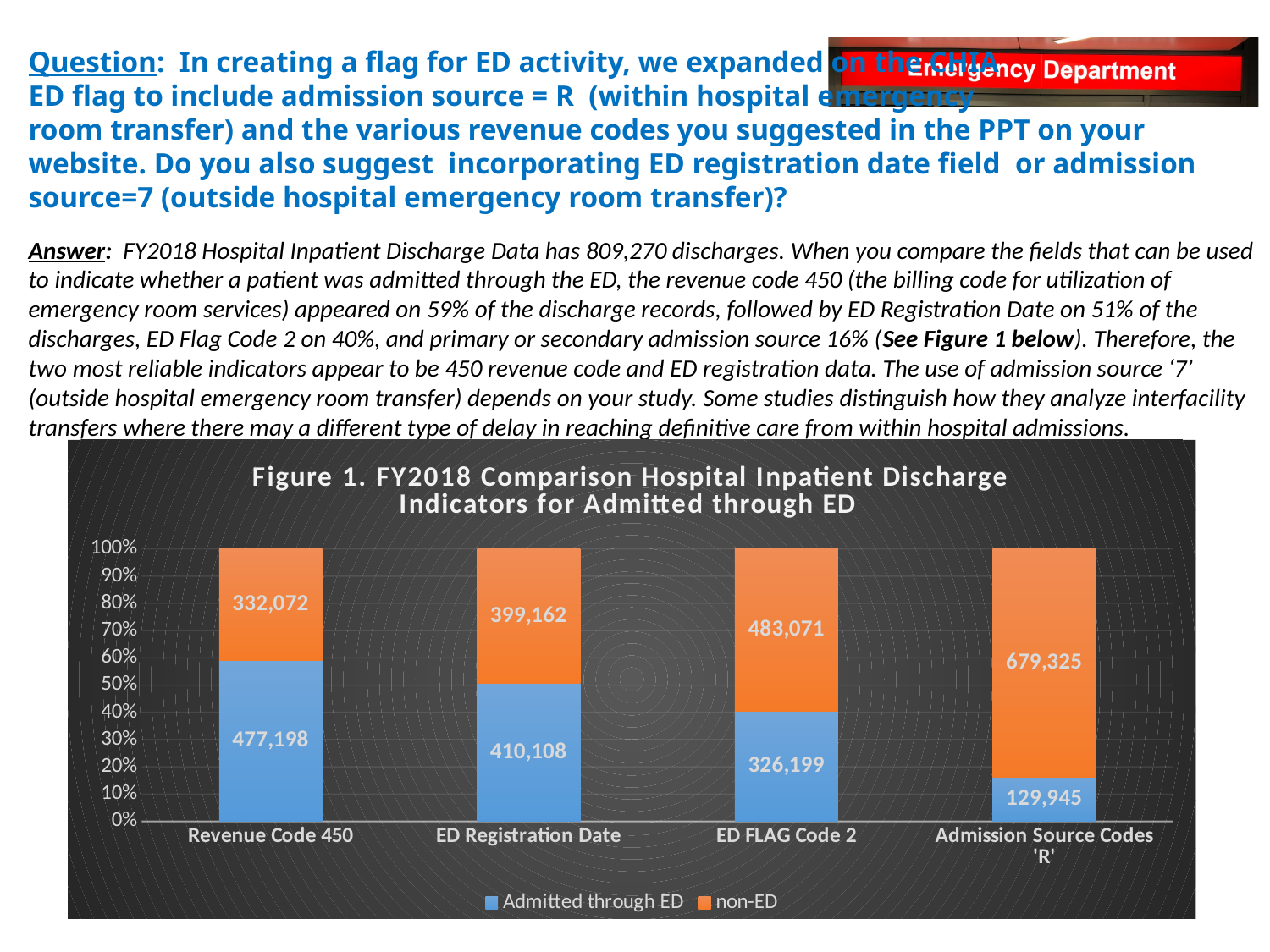
What kind of chart is shown? Stacked bar chart What is the total of the stacked bar for ED Registration Date? 809,270 How many categories are shown on the x axis? 4 What is the non-ED value for ED FLAG Code 2? 483,071 How many series does the legend list? 2 Which category has the lowest Admitted through ED value? Admission Source Codes 'R' What is the difference between the non-ED and Admitted through ED values for Admission Source Codes 'R'? 549,380 Which is larger for ED Registration Date: Admitted through ED or non-ED? Admitted through ED Which category has the highest Admitted through ED value? Revenue Code 450 What is the value for Admitted through ED for Revenue Code 450? 477,198 Is the Admitted through ED share for Revenue Code 450 greater or less than 50%? greater What is the Admitted through ED value for Admission Source Codes 'R'? 129,945